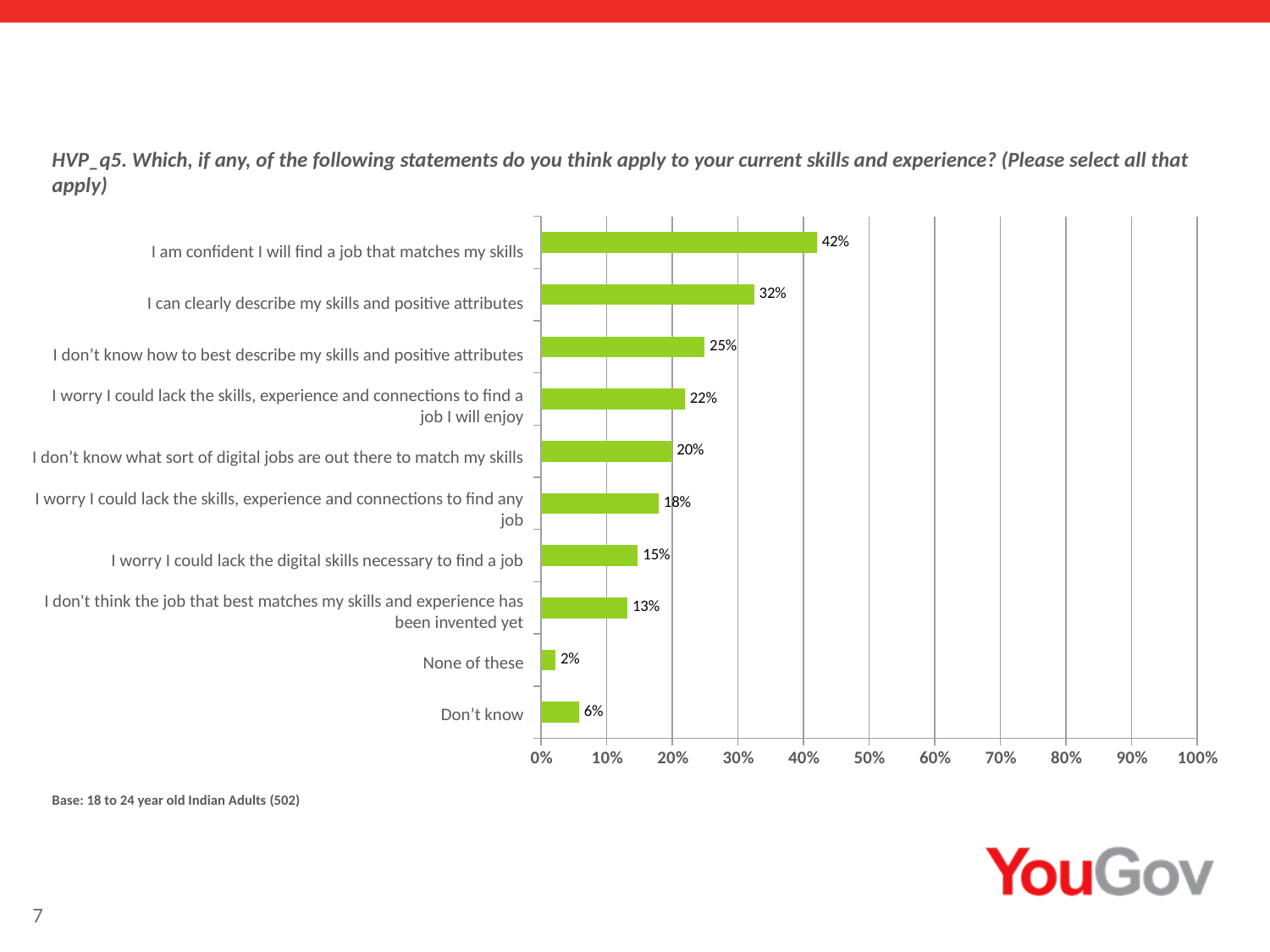
What is the difference between "I can clearly describe my skills and positive attributes" and "I don't know how to best describe my skills and positive attributes"? 7% What percentage of respondents said "I am confident I will find a job that matches my skills"? 42% What is the difference between the highest and lowest values in the chart? 40% What type of chart is shown on the slide? Bar chart Is the value for "I worry I could lack the skills, experience and connections to find a job I will enjoy" greater or less than 30%? less What percentage selected "Don't know"? 6% What is the base (sample) described below the chart? 18 to 24 year old Indian Adults (502) What is the value for "I worry I could lack the digital skills necessary to find a job"? 15% Which statement has the highest percentage? I am confident I will find a job that matches my skills How many categories are shown in the chart? 10 Which is larger: "I don't know what sort of digital jobs are out there to match my skills" or "I worry I could lack the skills, experience and connections to find any job"? I don't know what sort of digital jobs are out there to match my skills Which category has the lowest percentage? None of these